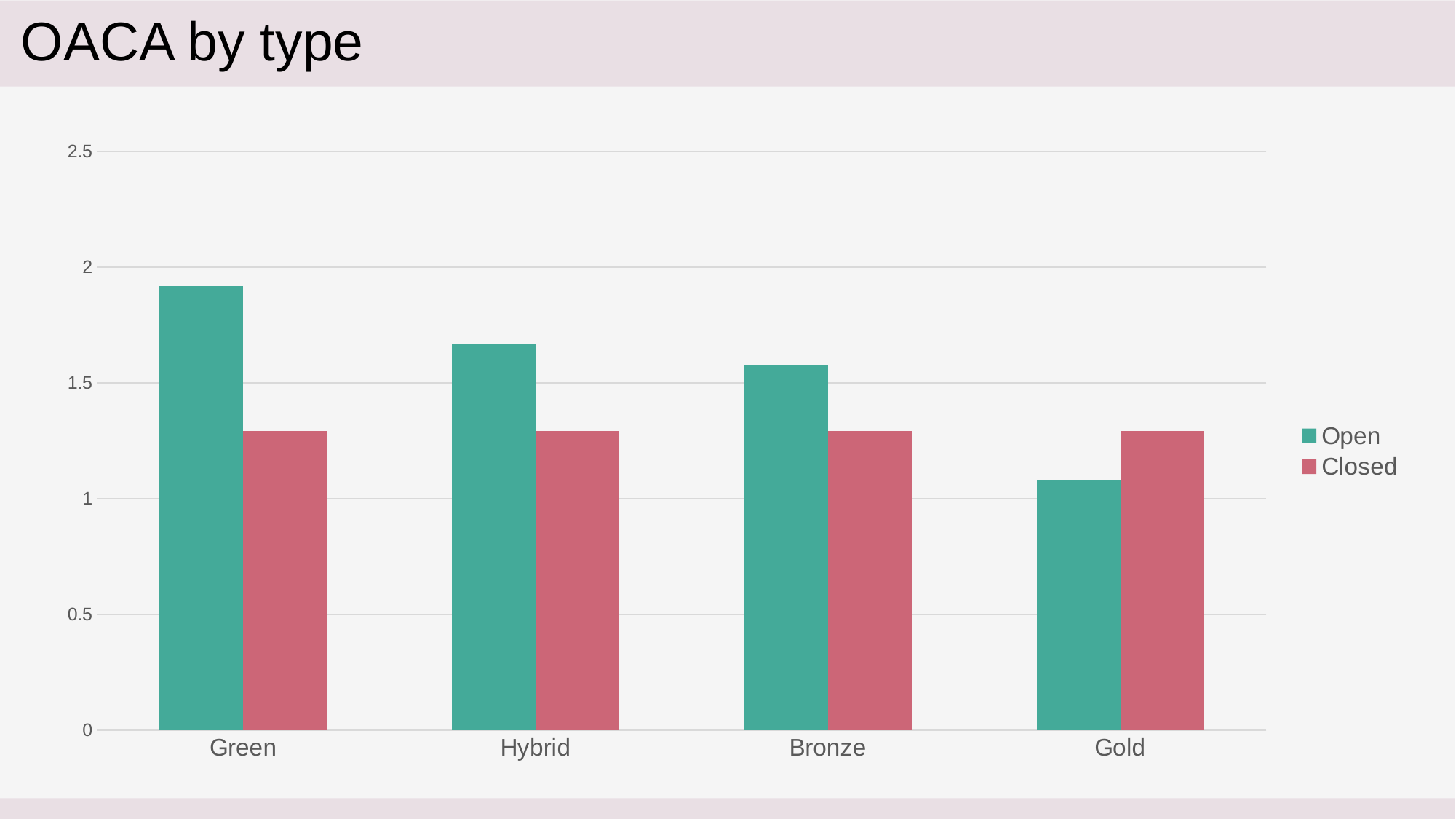
For Green, which is larger, the Open value or the Closed value? Open What is the title of the chart? OACA by type Is the Open value for Gold greater or less than 1.5? less Is the Open value for Green greater or less than 1.5? greater How many series does the legend list? 2 Is the Closed value for Green greater or less than 1.5? less Which category has the lowest Open value? Gold Which category has the highest Open value? Green What kind of chart is shown on the slide? bar chart For Gold, which is larger, the Open value or the Closed value? Closed How many categories are shown on the x axis? 4 Do the Open values rise or fall from Green to Gold along the x axis? fall